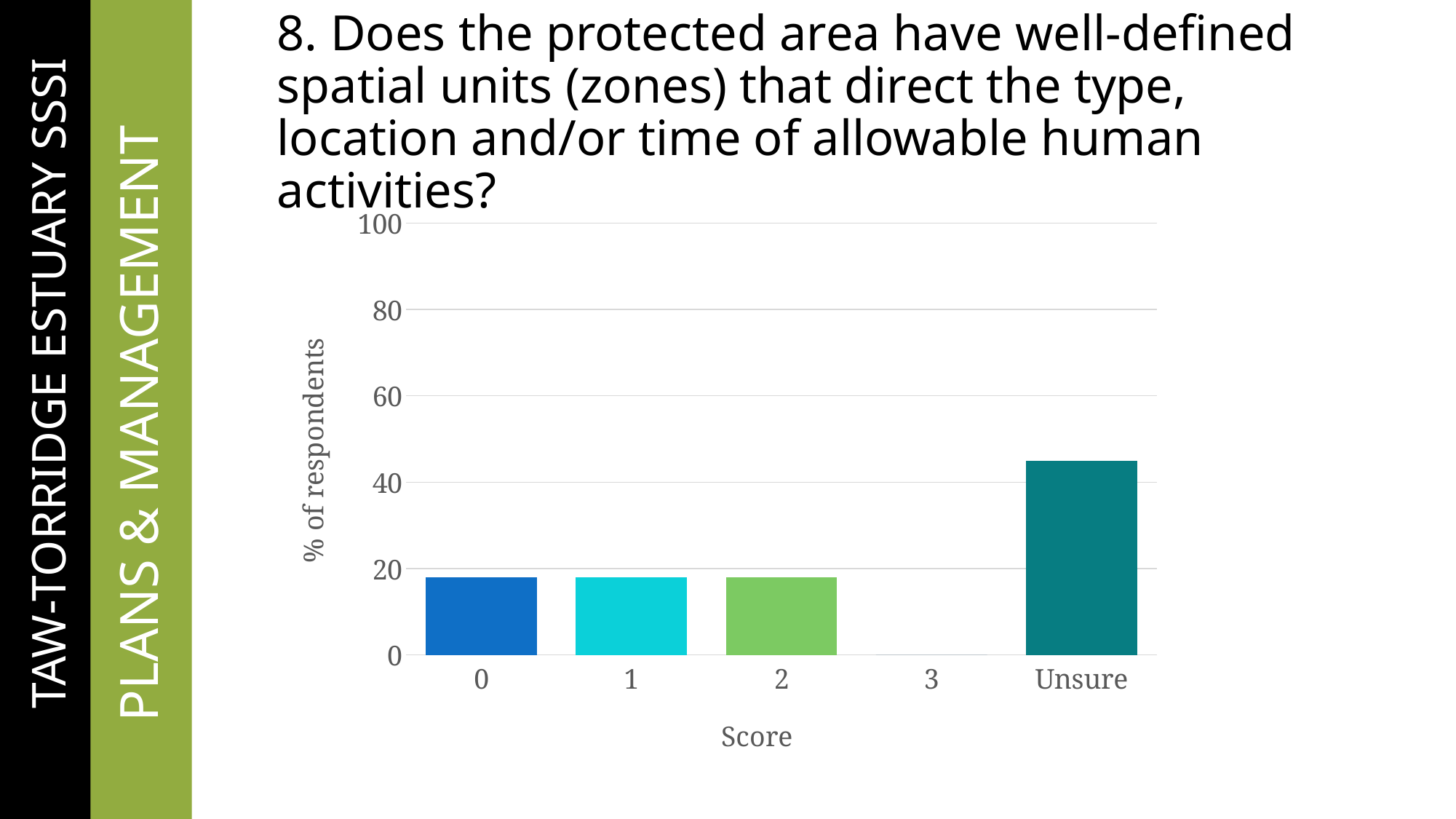
How many score categories are shown on the x axis of the chart? 5 Which has a higher percentage of respondents, score 1 or Unsure? Unsure What kind of chart is shown on the slide? bar chart Is the value for score 0 greater or less than 20? less Is the value for Unsure greater or less than 60? less Which has a higher percentage of respondents, score 3 or score 2? 2 Is the value for score 2 greater or less than 20? less What is the label on the x axis of the chart? Score What is the label on the y axis of the chart? % of respondents Which score category has the lowest percentage of respondents? 3 Which score category has the highest percentage of respondents? Unsure